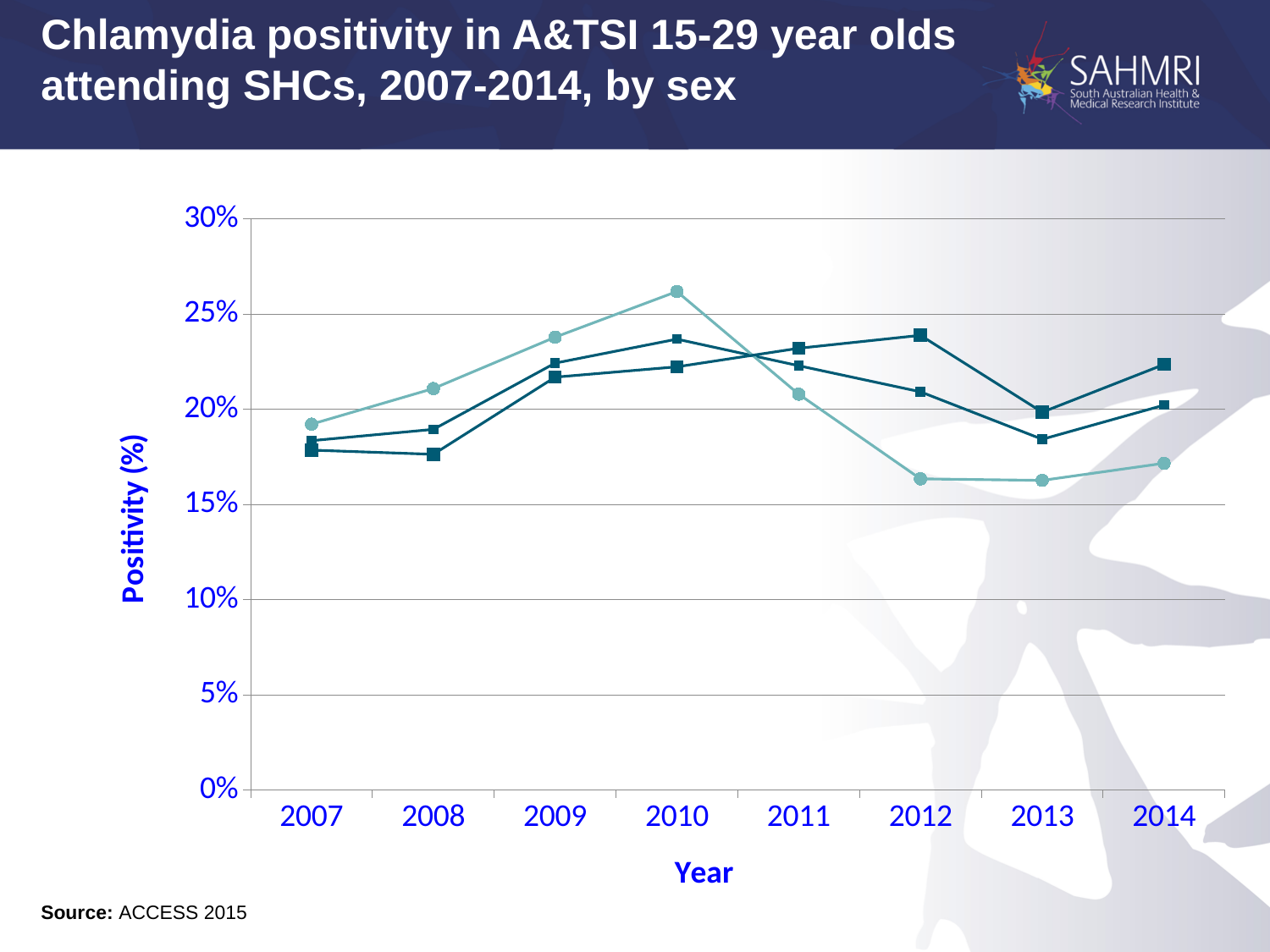
Is the value for the dark line with large square markers in 2012 greater or less than 20%? greater How many years are shown on the x axis of the chart? 8 Is the value for the light teal line with circle markers in 2012 greater or less than 20%? less Is the value for the light teal line with circle markers in 2013 greater or less than 15%? greater In 2010, which line is higher: the light teal line with circle markers or the dark line with large square markers? the light teal line with circle markers Does the light teal line with circle markers rise or fall between 2010 and 2012? fall In which year does the light teal line with circle markers reach its highest value? 2010 What is the title of the x axis? Year What kind of chart is shown on the slide? line chart In 2012, which line is higher: the dark line with large square markers or the light teal line with circle markers? the dark line with large square markers What is the title of the y axis? Positivity (%)